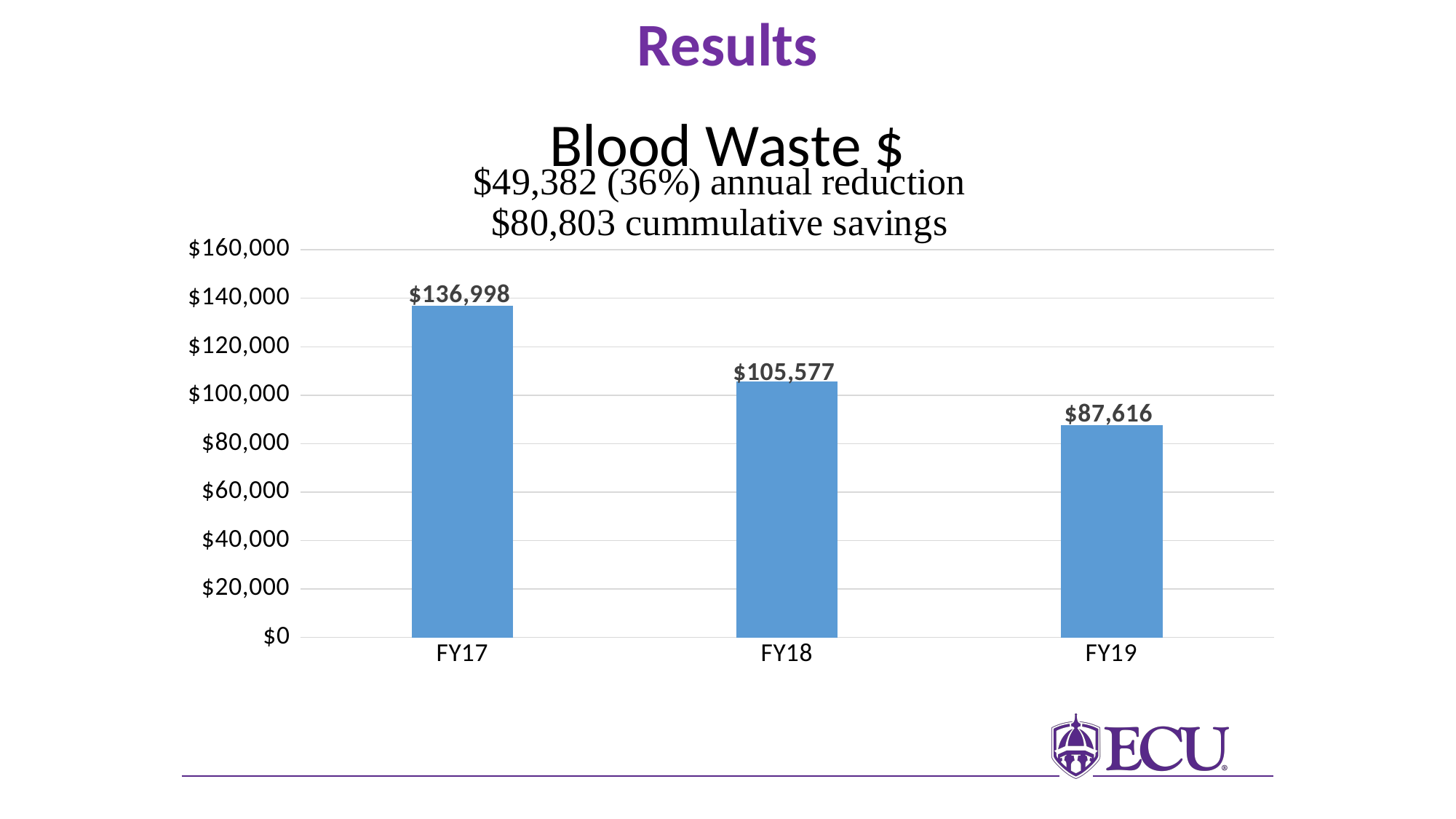
Is the value for FY19 greater or less than $100,000? less Do the blood waste values rise or fall from FY17 to FY19? fall Which fiscal year has the highest blood waste value? FY17 How many fiscal years are shown in the chart? 3 What is the difference between the FY18 and FY19 blood waste values? $17,961 What is the blood waste value for FY19? $87,616 What is the blood waste value for FY17? $136,998 Which fiscal year has the lowest blood waste value? FY19 What is the difference between the FY17 and FY18 blood waste values? $31,421 What kind of chart is shown on the slide? bar chart What is the blood waste value for FY18? $105,577 Which is larger, the blood waste value for FY18 or for FY19? FY18